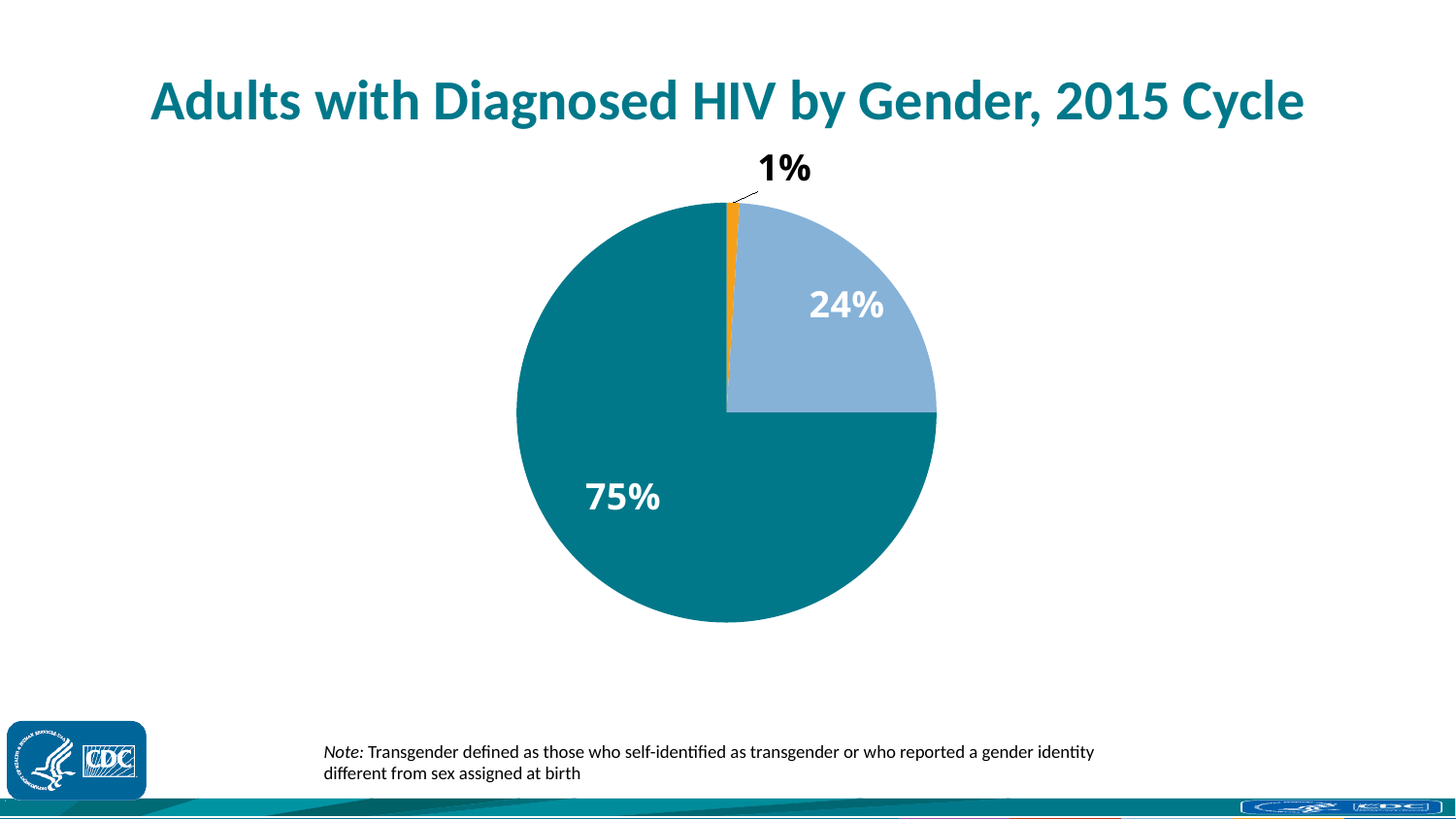
What colour is the largest slice of the pie chart? dark teal What kind of chart is shown on the slide? pie chart What is the value of the smallest slice of the pie chart? 1% What share of the pie does the light blue slice represent? 24% What is the value of the largest slice of the pie chart? 75% How many slices does the pie chart have? 3 What is the difference between the 24% slice and the 1% slice? 23 percentage points Which slice is larger, the light blue slice or the orange slice? the light blue slice What is the difference between the largest slice and the second-largest slice of the pie chart? 51 percentage points What share of the pie does the dark teal slice represent? 75% What is the title of the chart on the slide? Adults with Diagnosed HIV by Gender, 2015 Cycle What share of the pie does the orange slice represent? 1%